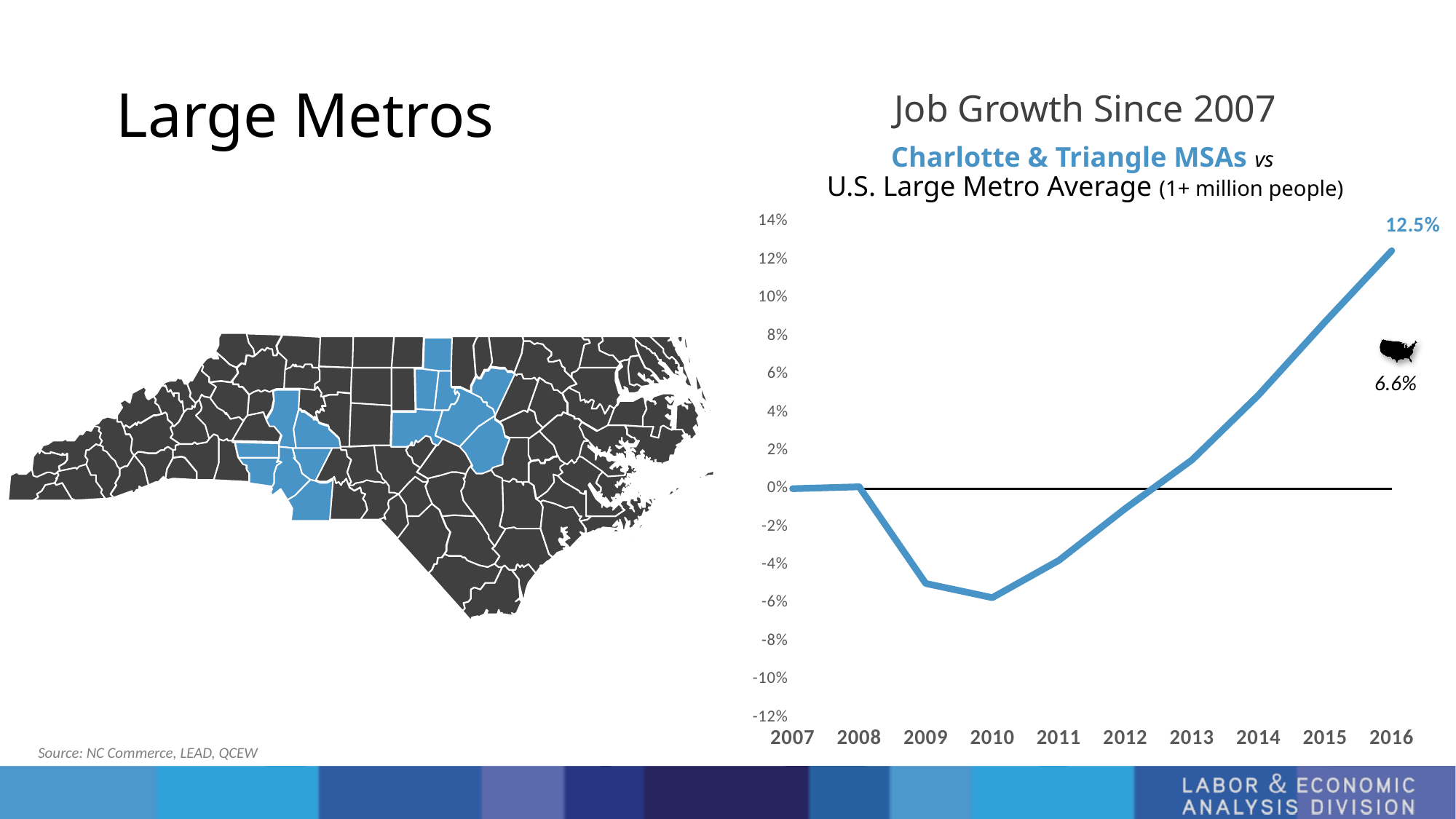
In which year is the Charlotte & Triangle MSAs job growth line at its lowest? 2010 In which year is the Charlotte & Triangle MSAs job growth line at its highest? 2016 Does the job growth line rise or fall between 2010 and 2016? Rise Is the value for 2011 greater or less than -2%? less What kind of chart is used to show job growth since 2007? Line chart By how many percentage points does the 2016 Charlotte & Triangle MSAs value exceed the U.S. Large Metro Average value? 5.9 percentage points Is the value for 2010 greater or less than -4%? less What is the job growth value shown for Charlotte & Triangle MSAs in 2016? 12.5% Which is larger in 2016: the Charlotte & Triangle MSAs job growth or the U.S. Large Metro Average? Charlotte & Triangle MSAs What job growth value is shown for the U.S. Large Metro Average? 6.6% Is the value for 2014 greater or less than 4%? greater How many years are shown on the x axis of the chart? 10